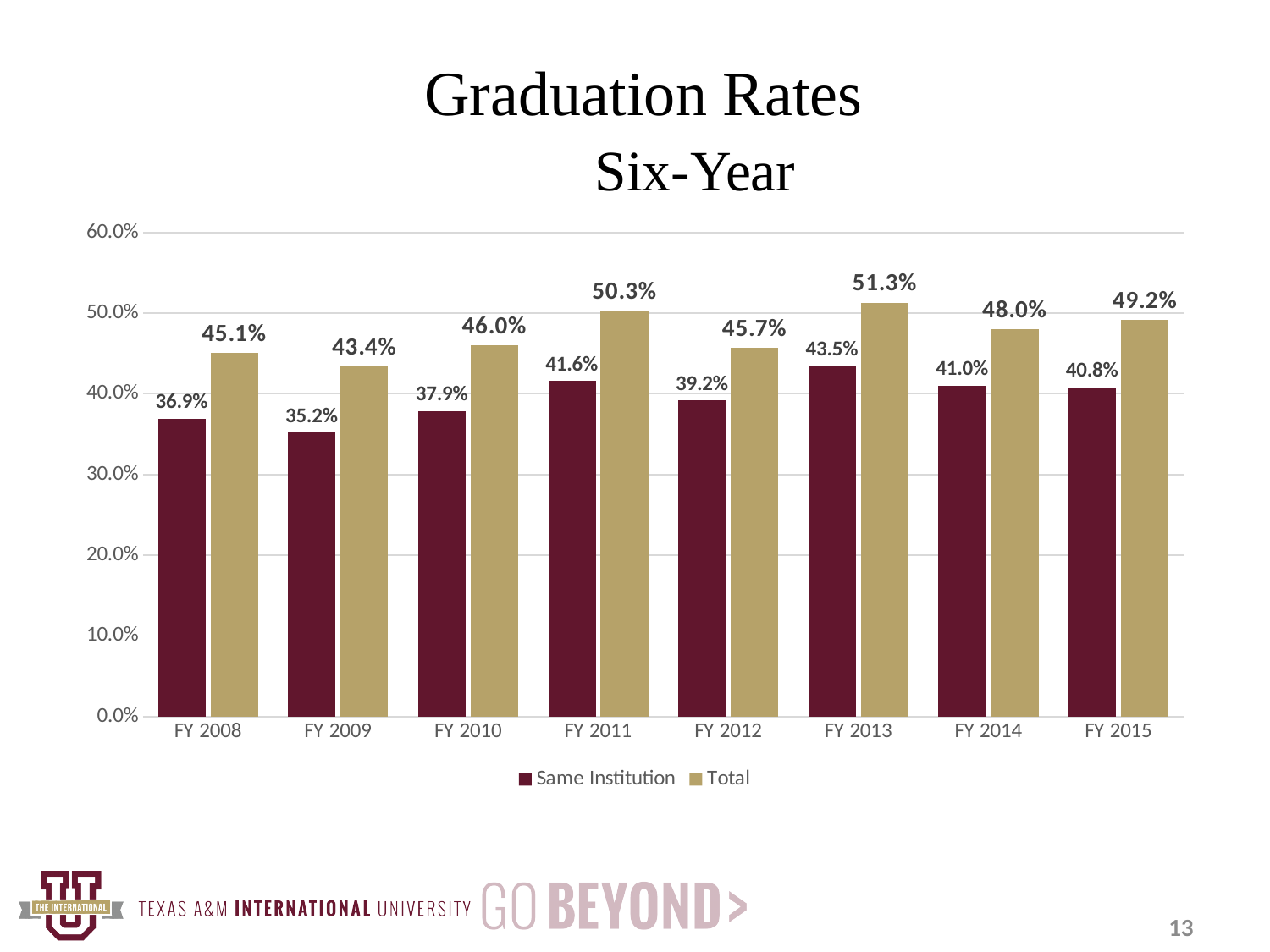
How many fiscal years are shown on the x axis? 8 Which fiscal year has the highest Total graduation rate? FY 2013 What is the difference between the Total and Same Institution rates for FY 2011? 8.7% What is the Same Institution six-year graduation rate for FY 2008? 36.9% What is the Total six-year graduation rate for FY 2013? 51.3% Is the Same Institution value for FY 2013 greater or less than 40.0%? greater Which fiscal year has the lowest Same Institution graduation rate? FY 2009 What are the two series named in the legend? Same Institution and Total What kind of chart is shown on the slide? Bar chart Which is larger, the Total rate for FY 2014 or the Total rate for FY 2015? FY 2015 How many series does the legend list? 2 What is the Same Institution value for FY 2015? 40.8%